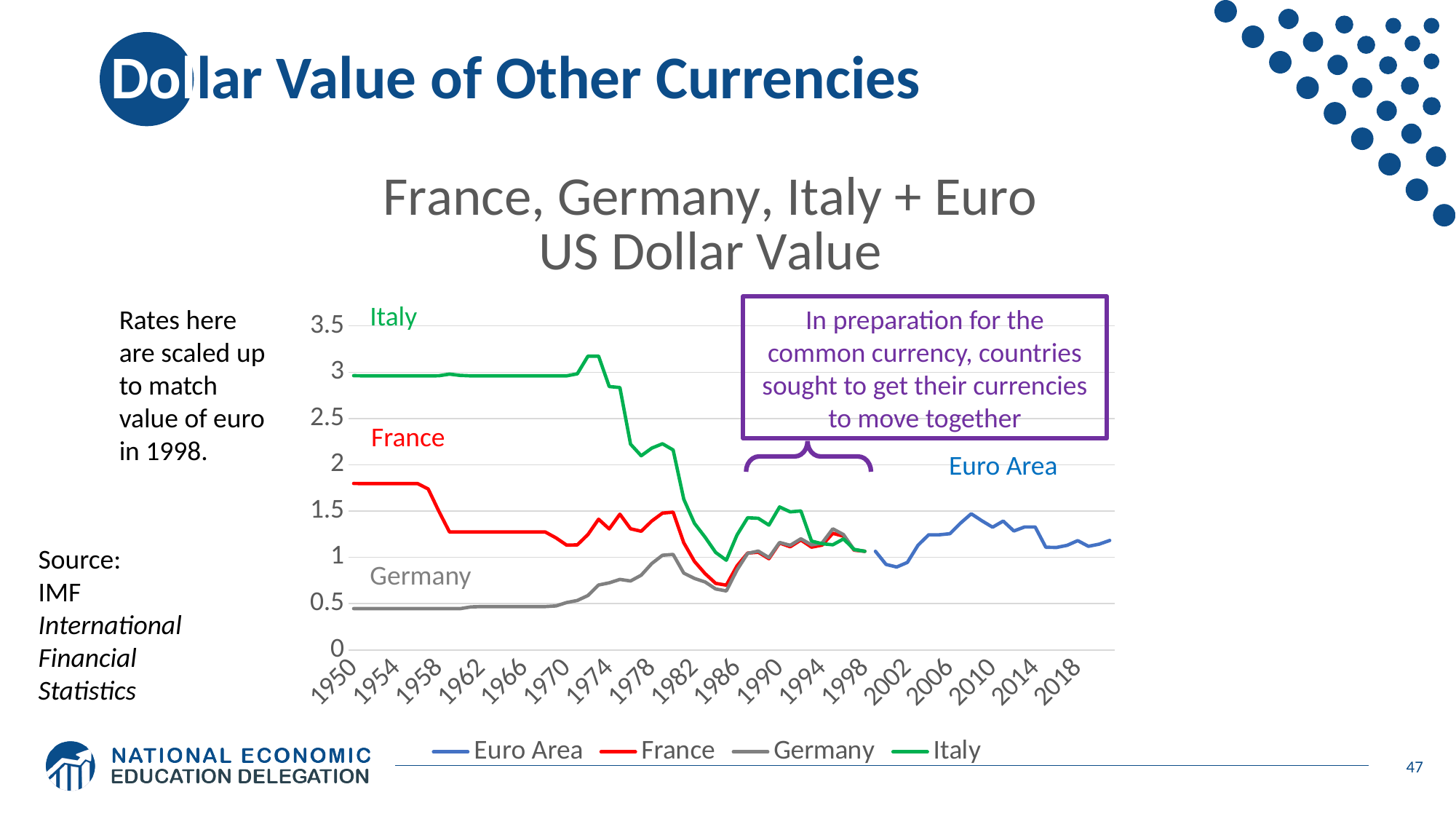
What is the title of the chart? France, Germany, Italy + Euro US Dollar Value Which series has the lowest value in 1950? Germany Is the value for France in 1950 greater or less than 1.5? greater What are the series listed in the chart legend? Euro Area, France, Germany, Italy How many series does the chart legend list? 4 What kind of chart is shown on the slide? line chart Does the Italy line rise or fall overall from 1950 to 1998? fall Is the value for Germany in 1950 greater or less than 1? less Which series has the highest value in 1950? Italy Is the value for Italy in 1950 greater or less than 2.5? greater In 1970, which is larger: the value for France or the value for Germany? France Does the Germany line rise or fall overall from 1950 to 1998? rise